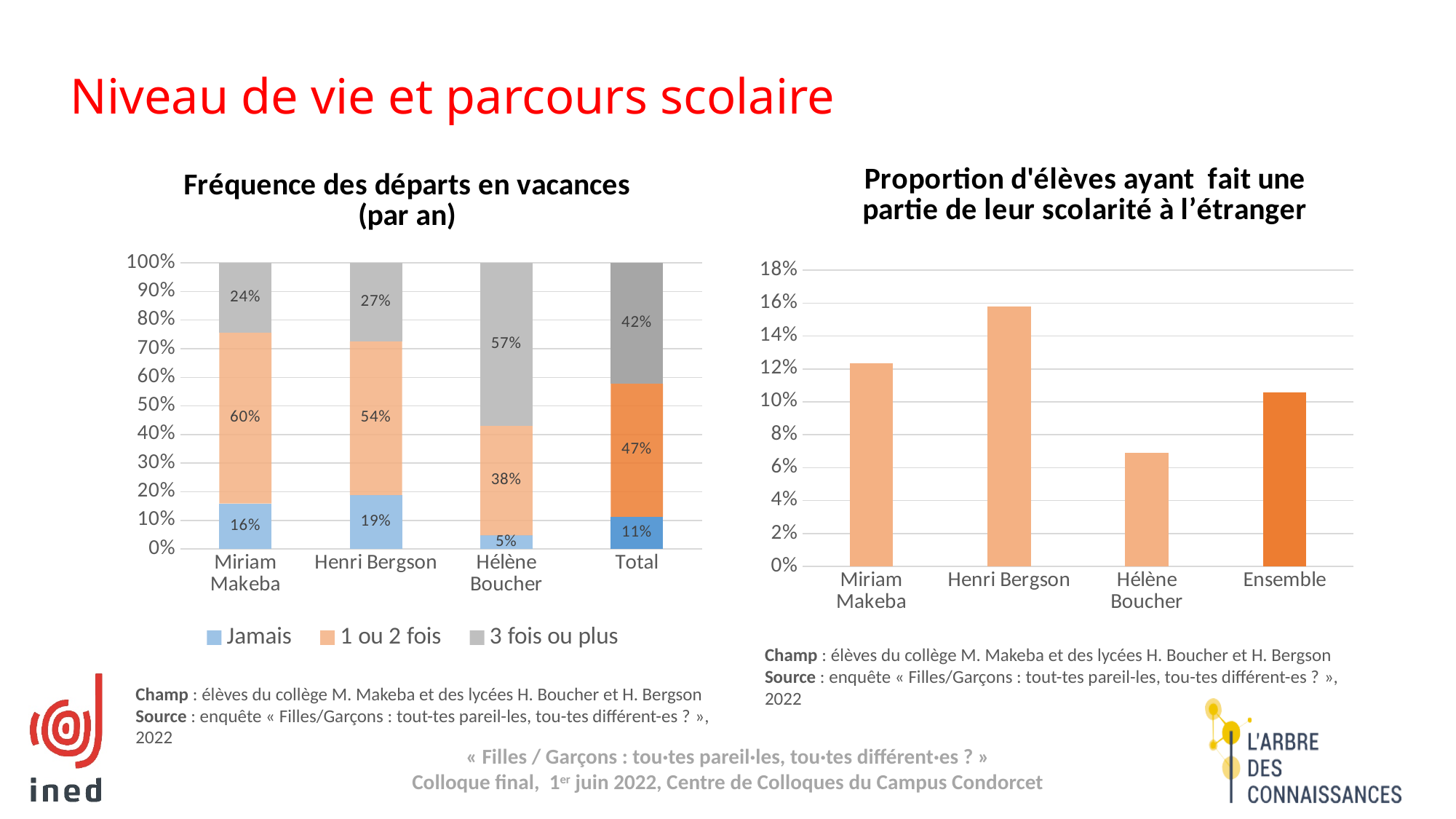
In the chart 'Fréquence des départs en vacances (par an)', which category has the highest value for 'Jamais'? Henri Bergson In the chart 'Fréquence des départs en vacances (par an)', how many series does the legend list? 3 In the chart 'Fréquence des départs en vacances (par an)', what is the difference between the '1 ou 2 fois' values for Miriam Makeba and Henri Bergson? 6 percentage points In the chart 'Proportion d'élèves ayant fait une partie de leur scolarité à l'étranger', how many categories are shown on the x axis? 4 In the chart 'Fréquence des départs en vacances (par an)', which category has the lowest value for '1 ou 2 fois'? Hélène Boucher In the chart 'Fréquence des départs en vacances (par an)', which series is shown in grey? 3 fois ou plus In the chart 'Proportion d'élèves ayant fait une partie de leur scolarité à l'étranger', is the value for Miriam Makeba greater or less than 10%? greater In the chart 'Fréquence des départs en vacances (par an)', what is the value of 'Jamais' for Henri Bergson? 19% In the chart 'Proportion d'élèves ayant fait une partie de leur scolarité à l'étranger', which category has the highest value? Henri Bergson In the chart 'Proportion d'élèves ayant fait une partie de leur scolarité à l'étranger', which category has the lowest value? Hélène Boucher In the chart 'Fréquence des départs en vacances (par an)', what is the value of '1 ou 2 fois' for Total? 47% In the chart 'Fréquence des départs en vacances (par an)', what is the value of '3 fois ou plus' for Hélène Boucher? 57%